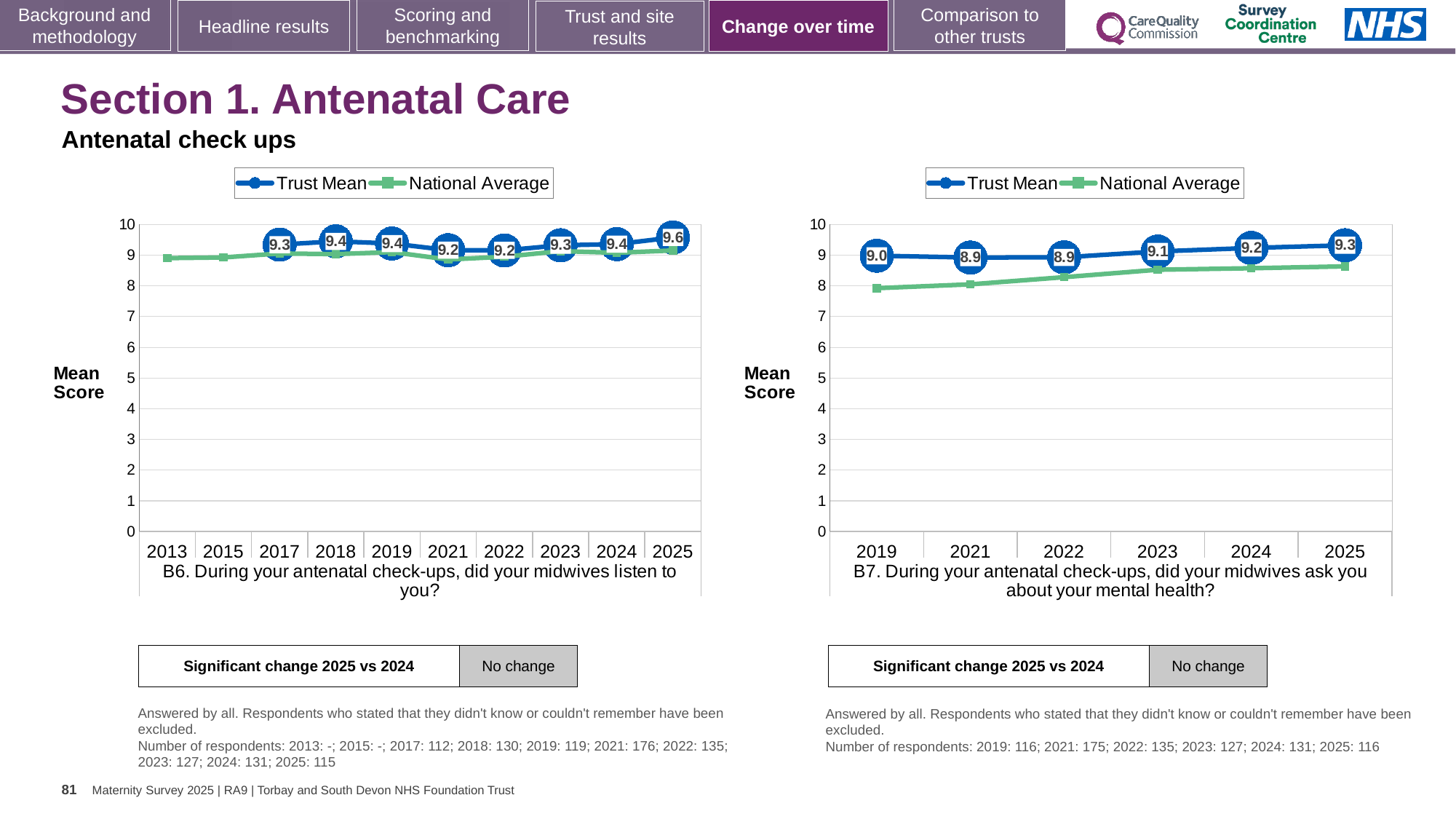
In the B7 chart (right), which year has the highest Trust Mean? 2025 In the B6 chart (left), which year has the highest Trust Mean? 2025 What kind of chart is the B6 chart (left)? line chart How many series does the legend of the B7 chart (right) list? 2 In the B7 chart (right), what is the Trust Mean for 2019? 9.0 How many years are shown on the x axis of the B6 chart (left)? 10 In the B7 chart (right), does the Trust Mean rise or fall from 2022 to 2025? rise In the B7 chart (right), what is the difference between the Trust Mean in 2025 and in 2021? 0.4 In the B6 chart (left), what is the Trust Mean for 2025? 9.6 In the B7 chart (right), is the Trust Mean for 2023 higher or lower than the Trust Mean for 2022? higher In the B6 chart (left), what is the difference between the Trust Mean in 2025 and in 2024? 0.2